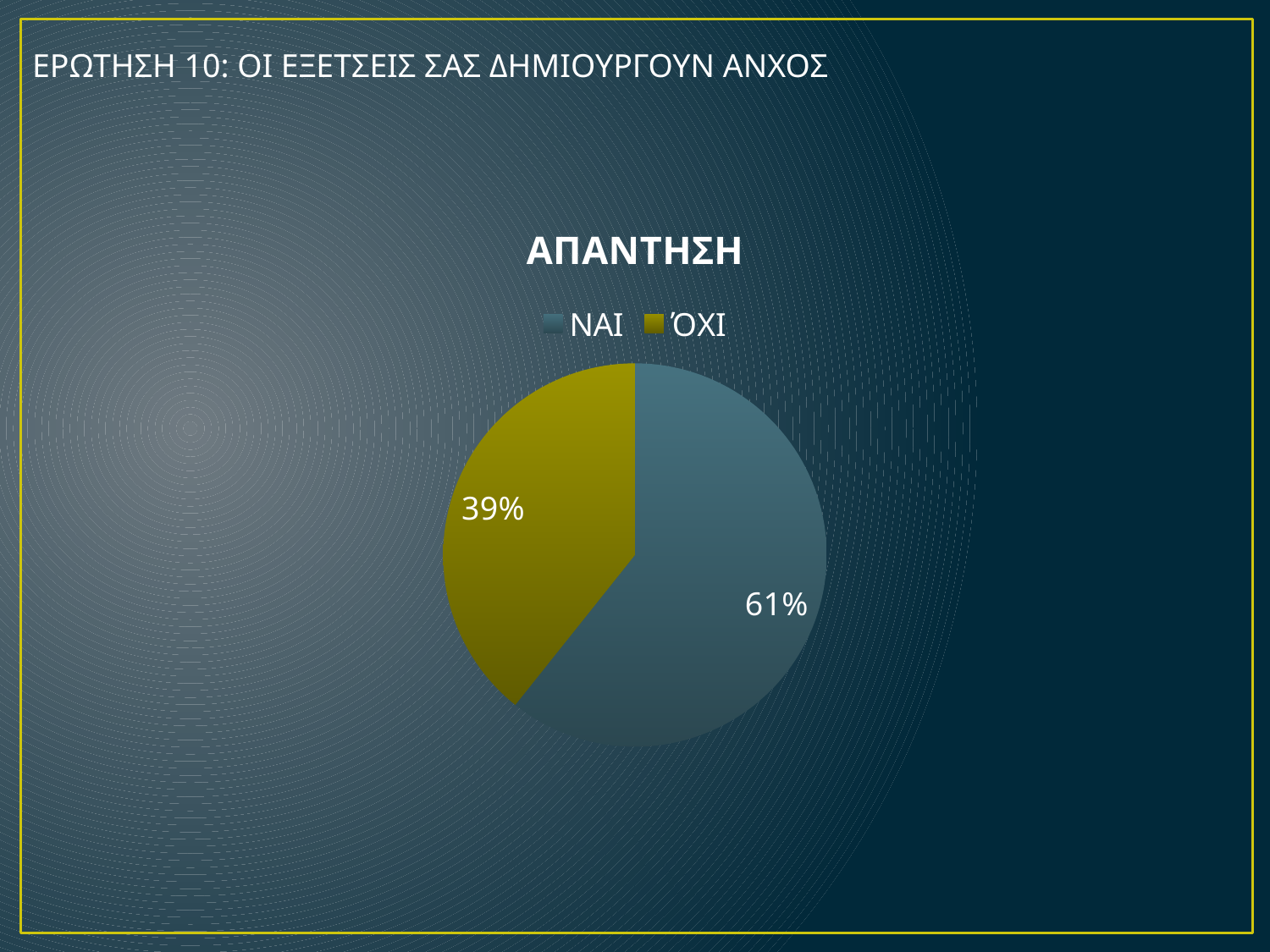
What share of the pie is ΝΑΙ? 61% What type of chart is shown on the slide? pie chart How many entries does the legend list? 2 What is the difference in percentage points between ΝΑΙ and ΌΧΙ? 22% What share of the pie is ΌΧΙ? 39% What is the title of the chart? ΑΠΑΝΤΗΣΗ How many slices does the pie chart have? 2 Which category has the smallest slice? ΌΧΙ Which category has the largest slice? ΝΑΙ What colour is the ΌΧΙ slice? olive/yellow Which is larger, the ΝΑΙ slice or the ΌΧΙ slice? ΝΑΙ